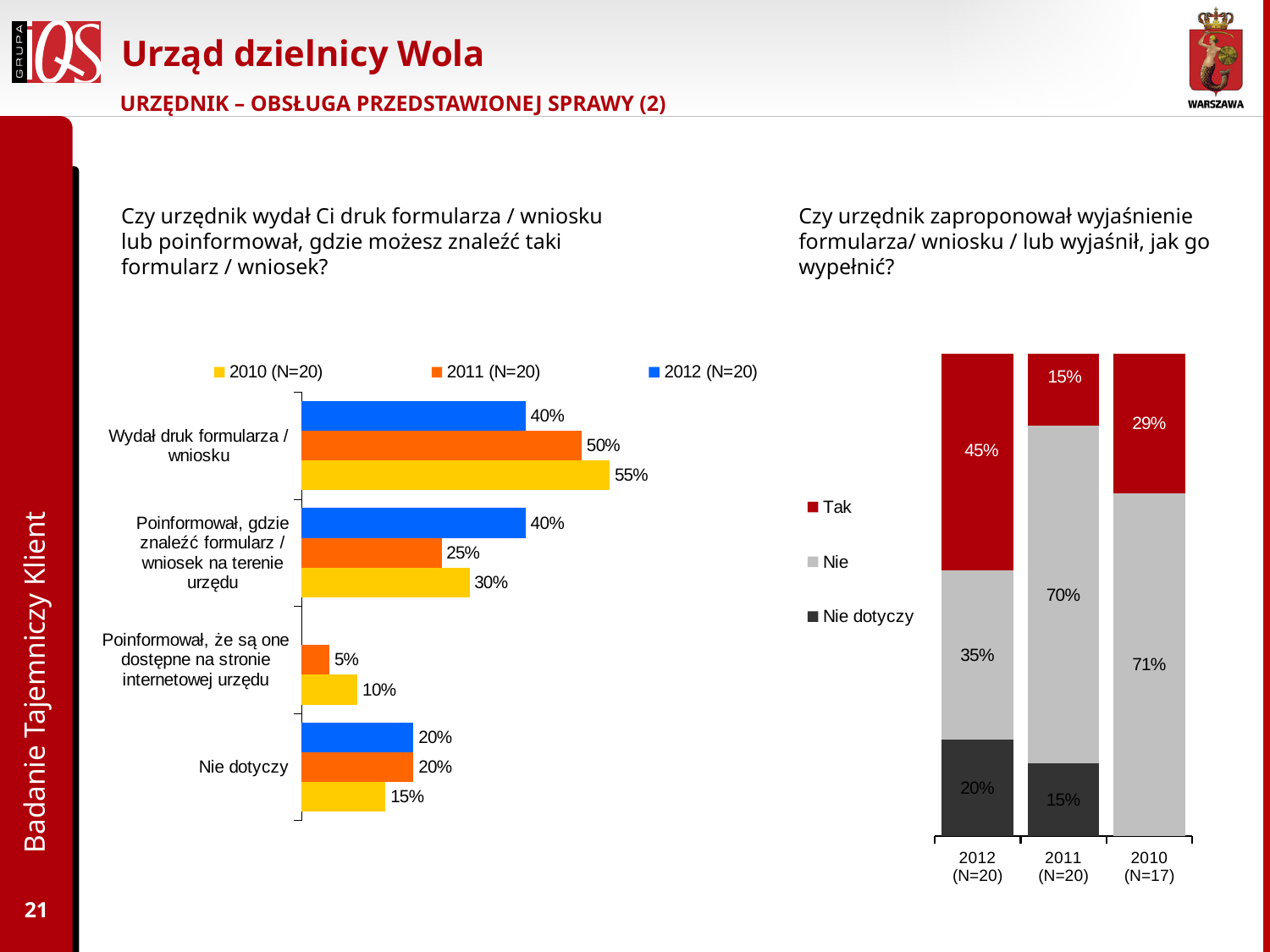
In the left chart, how many series does the legend list? 3 In the left chart, what is the 2011 (N=20) value for 'Poinformował, gdzie znaleźć formularz / wniosek na terenie urzędu'? 25% In the left chart, what is the 2010 (N=20) value for 'Wydał druk formularza / wniosku'? 55% In the right chart, what is the 'Tak' share for 2012 (N=20)? 45% In the right chart, which year has the lowest 'Tak' share? 2011 (N=20) In the left chart, how many categories are shown on the vertical axis? 4 In the left chart, what is the difference between the 2010 and 2012 values for 'Wydał druk formularza / wniosku'? 15 percentage points In the left chart, what is the 2010 (N=20) value for 'Poinformował, że są one dostępne na stronie internetowej urzędu'? 10% In the right chart, is the 'Nie' share larger for 2010 (N=17) or for 2012 (N=20)? 2010 (N=17) In the right chart, what is the 'Nie' share for 2011 (N=20)? 70% What type of chart is the left chart? Bar chart In the left chart, which category has the highest 2012 (N=20) value? Wydał druk formularza / wniosku and Poinformował, gdzie znaleźć formularz / wniosek na terenie urzędu (both 40%)